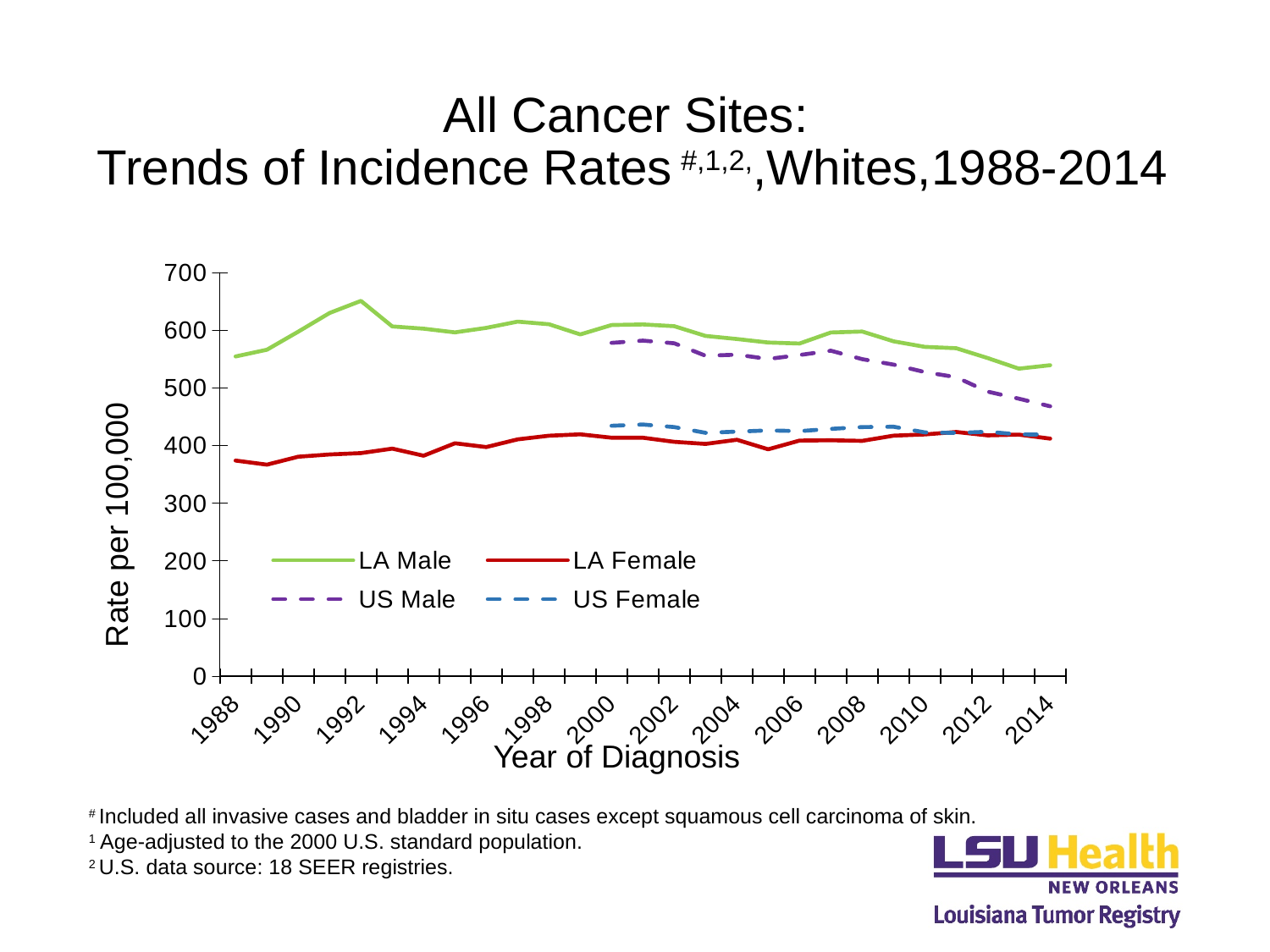
Which is larger in 2010, the LA Male value or the US Male value? LA Male Is the value for US Female in 2000 greater or less than 400? greater Does the US Male series rise or fall from 2000 to 2014? fall What kind of chart is shown on the slide? line chart Is the value for LA Male in 1992 greater or less than 600? greater How many series does the legend list? 4 Is the value for LA Female in 1988 greater or less than 400? less Which series is drawn as a purple dashed line? US Male What is the label of the y axis? Rate per 100,000 Which is larger in 2000, the LA Male value or the LA Female value? LA Male In which year does the LA Male series reach its highest value? 1992